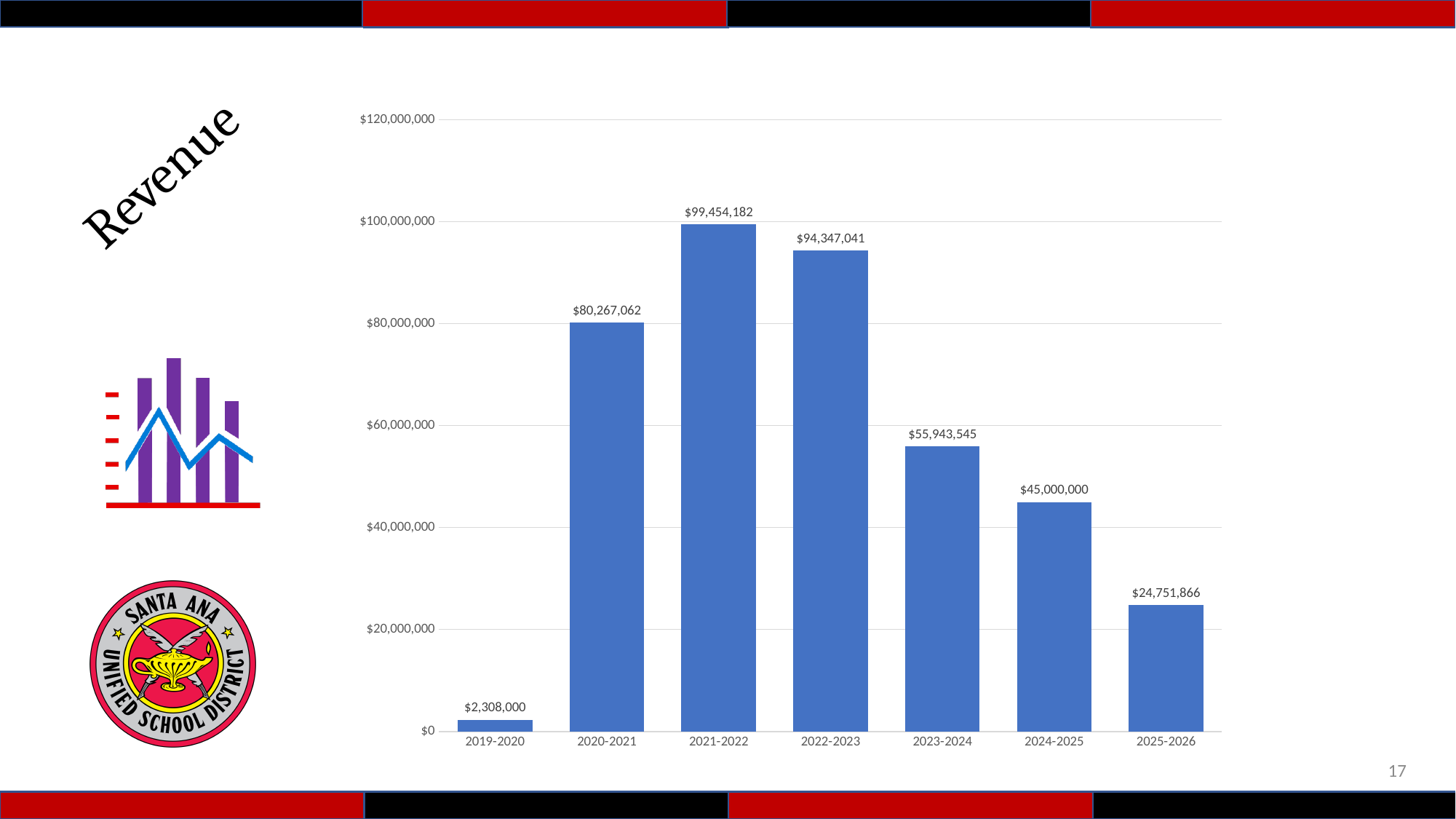
What is the difference between the revenue for 2021-2022 and 2022-2023? $5,107,141 What is the revenue value for 2024-2025? $45,000,000 What is the revenue value for 2019-2020? $2,308,000 What kind of chart is shown on the slide? bar chart Which is larger, the revenue for 2023-2024 or 2025-2026? 2023-2024 What is the title text shown on the slide for the chart? Revenue Do the revenue values rise or fall from 2022-2023 to 2025-2026? fall Which year has the highest revenue? 2021-2022 What is the revenue value for 2021-2022? $99,454,182 How many years are shown on the x axis of the chart? 7 Is the revenue for 2020-2021 greater or less than $60,000,000? greater Which year has the lowest revenue? 2019-2020